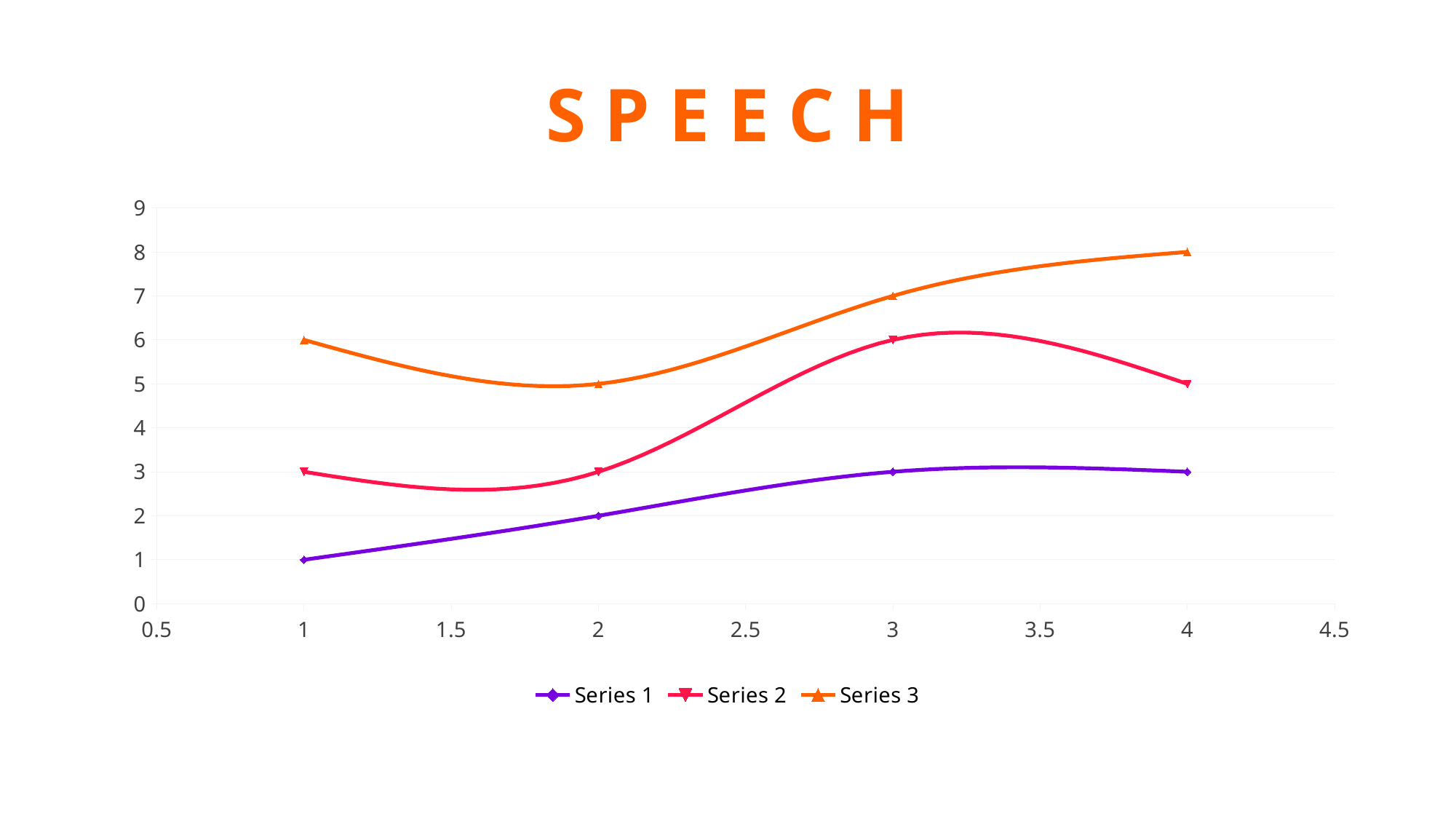
At x = 2, which series has the larger value, Series 2 or Series 3? Series 3 How many series does the legend list? 3 What is the title of the chart? SPEECH What is the difference between Series 3 and Series 1 at x = 4? 5 Does Series 1 rise or fall from x = 1 to x = 3? rise At which x value does Series 3 reach its highest point? 4 How many data points are plotted for Series 1? 4 At which x value does Series 3 reach its lowest point? 2 What type of chart is shown on the slide? line chart What is the value of Series 3 at x = 4? 8 What is the value of Series 1 at x = 1? 1 What is the value of Series 2 at x = 3? 6